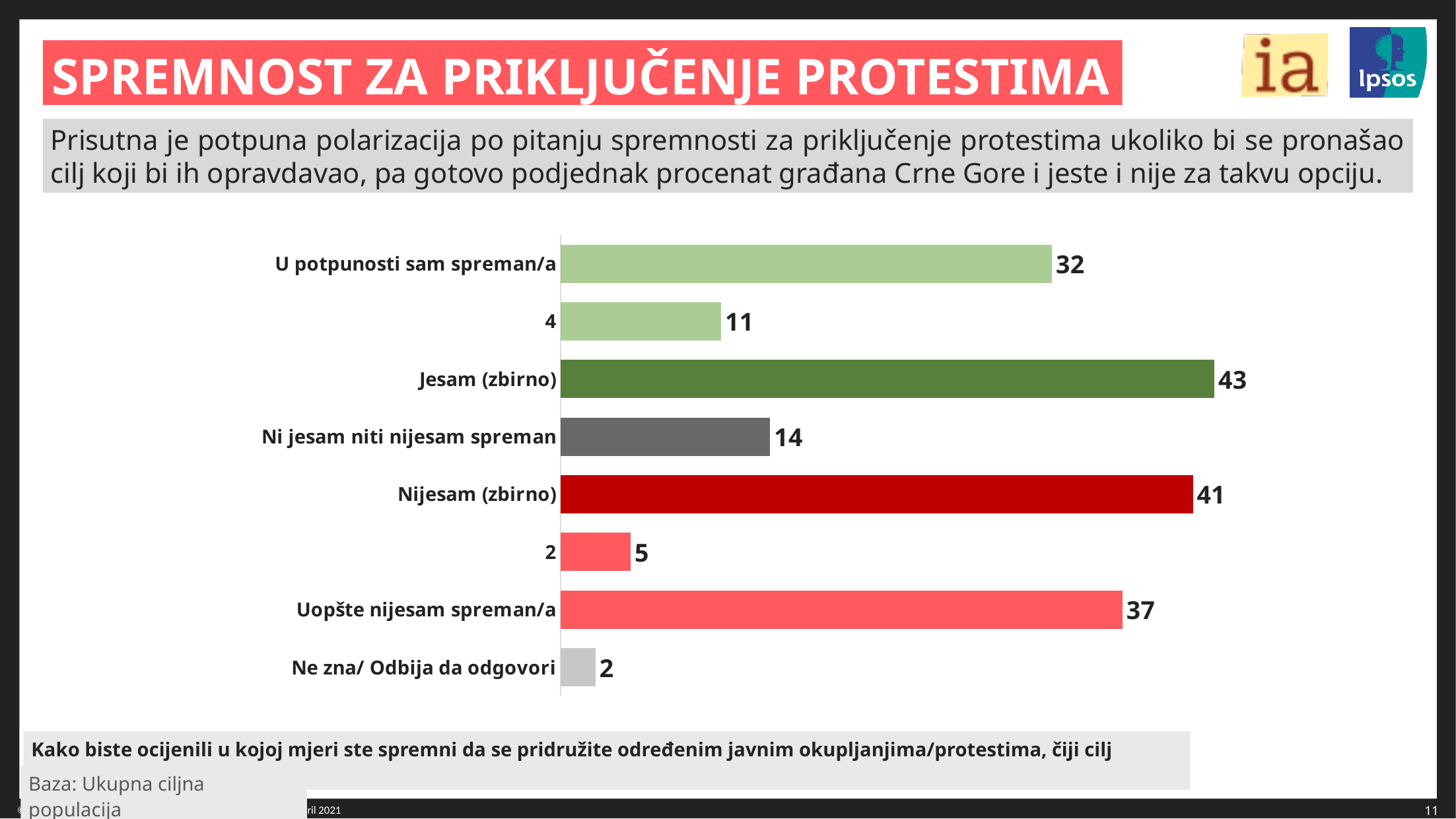
What is the value for "Ne zna/ Odbija da odgovori"? 2 What is the value for "Ni jesam niti nijesam spreman"? 14 What is the difference between "Uopšte nijesam spreman/a" and "U potpunosti sam spreman/a"? 5 How many categories are shown in the chart? 8 Which is larger, the value for "U potpunosti sam spreman/a" or the value for "Ni jesam niti nijesam spreman"? U potpunosti sam spreman/a Which category has the highest value? Jesam (zbirno) What is the value for "U potpunosti sam spreman/a"? 32 What is the value for "Uopšte nijesam spreman/a"? 37 What is the difference between "Jesam (zbirno)" and "Nijesam (zbirno)"? 2 Which category has the lowest value? Ne zna/ Odbija da odgovori What is the value for "Jesam (zbirno)"? 43 What kind of chart is shown on the slide? Bar chart